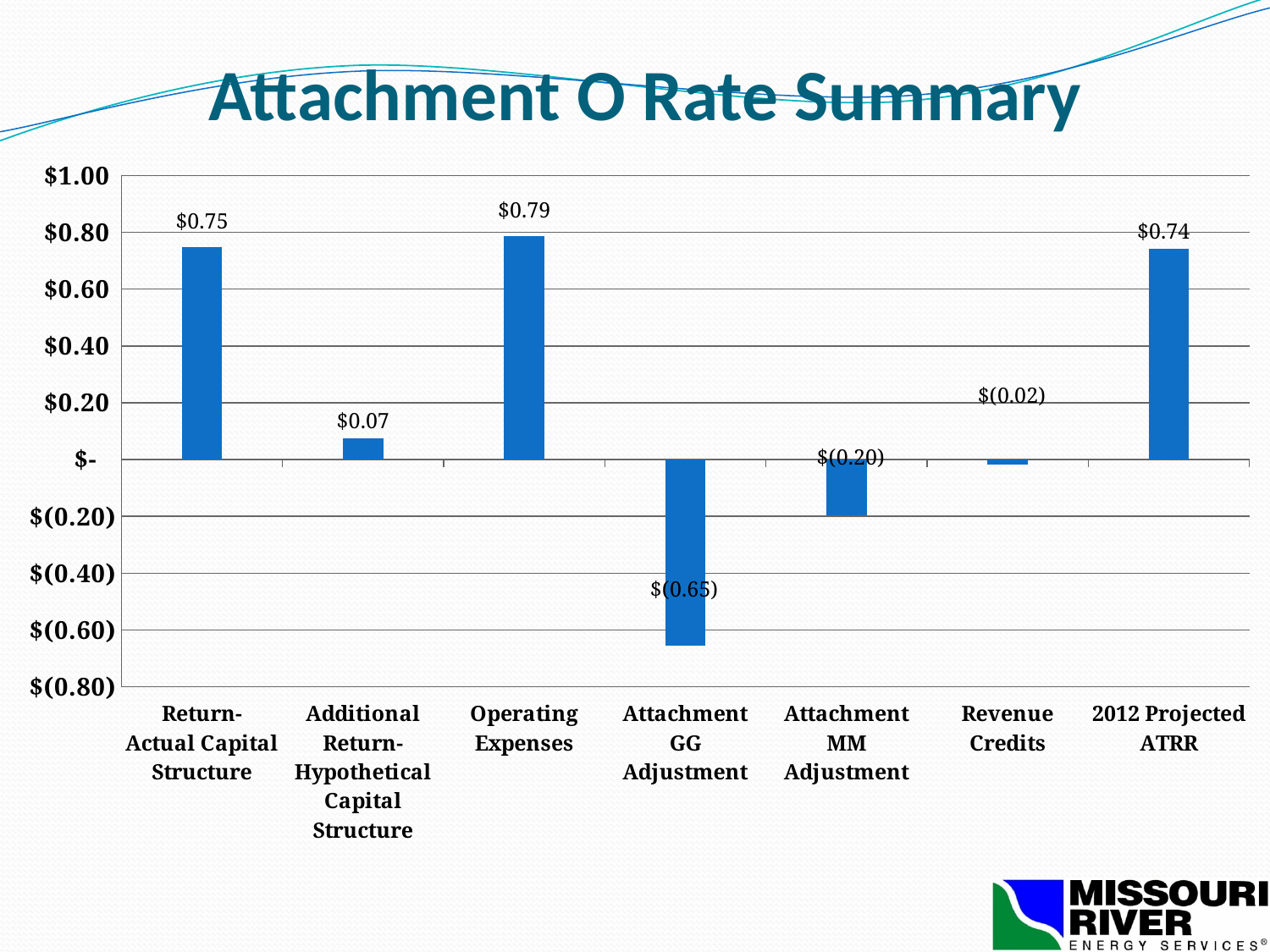
What is the value for Revenue Credits? $(0.02) Is the value for Attachment MM Adjustment greater or less than $(0.40)? greater What kind of chart is shown on the slide? Bar chart What is the title of the chart? Attachment O Rate Summary Which category has the highest value? Operating Expenses Which category has the lowest value? Attachment GG Adjustment How many categories are shown on the x axis? 7 What is the value for 2012 Projected ATRR? $0.74 What is the difference between the values for Return-Actual Capital Structure and Additional Return-Hypothetical Capital Structure? $0.68 What is the value for Attachment GG Adjustment? $(0.65) What is the value for Operating Expenses? $0.79 Which is larger, the value for Return-Actual Capital Structure or the value for 2012 Projected ATRR? Return-Actual Capital Structure